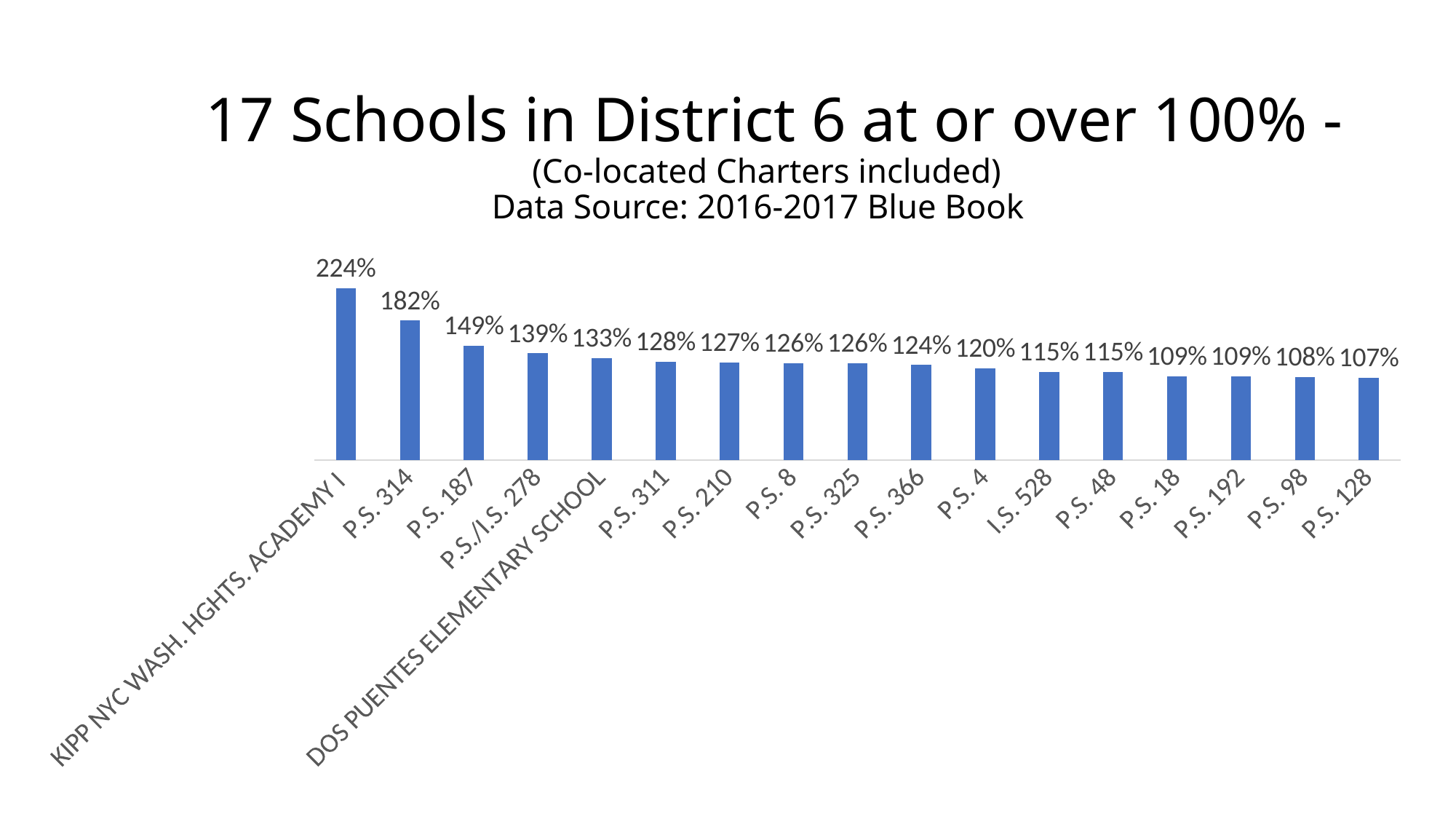
Which school has the lowest value? P.S. 128 Which is larger, the value for P.S./I.S. 278 or the value for P.S. 311? P.S./I.S. 278 Which school has the highest value? KIPP NYC WASH. HGHTS. ACADEMY I What kind of chart is shown on the slide? Bar chart Do the values rise or fall from left to right along the x axis? Fall What is the value for P.S. 314? 182% What is the value for P.S. 128? 107% What is the value for DOS PUENTES ELEMENTARY SCHOOL? 133% What is the difference between the values for KIPP NYC WASH. HGHTS. ACADEMY I and P.S. 314? 42% What is the value for P.S. 366? 124% How many schools are shown in the chart? 17 What is the difference between the values for P.S. 187 and P.S. 4? 29%